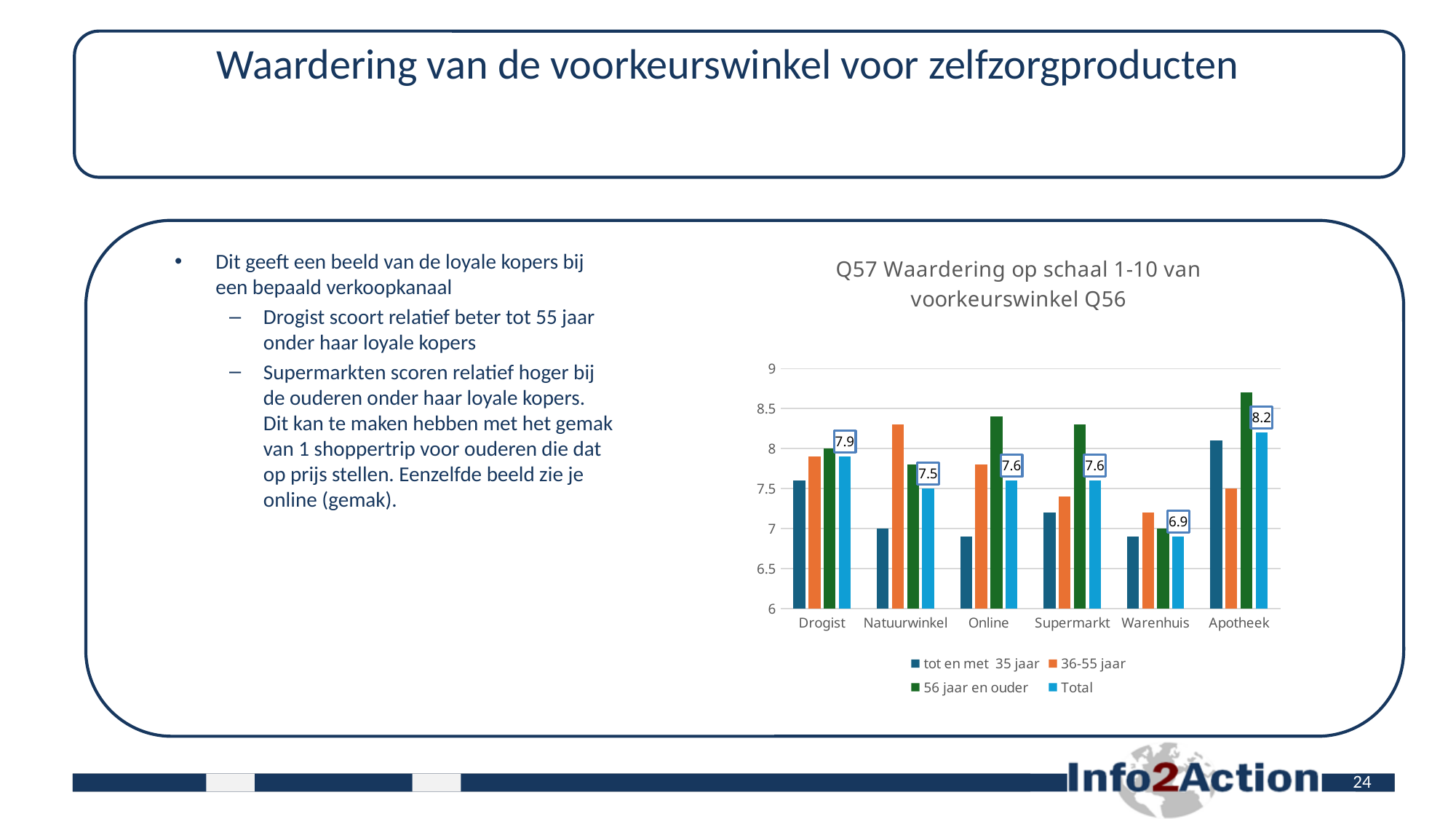
Is the value for 56 jaar en ouder at Apotheek greater or less than 8.5? greater What kind of chart is shown on the slide? bar chart What is the Total value for Drogist? 7.9 What is the Total value for Apotheek? 8.2 What is the Total value for Warenhuis? 6.9 Is the value for tot en met 35 jaar at Natuurwinkel greater or less than 7.5? less Which has a larger Total value, Drogist or Natuurwinkel? Drogist What is the difference between the Total values for Apotheek and Warenhuis? 1.3 How many categories are shown on the x axis? 6 Which category has the lowest Total value? Warenhuis Which category has the highest Total value? Apotheek How many series does the legend list? 4